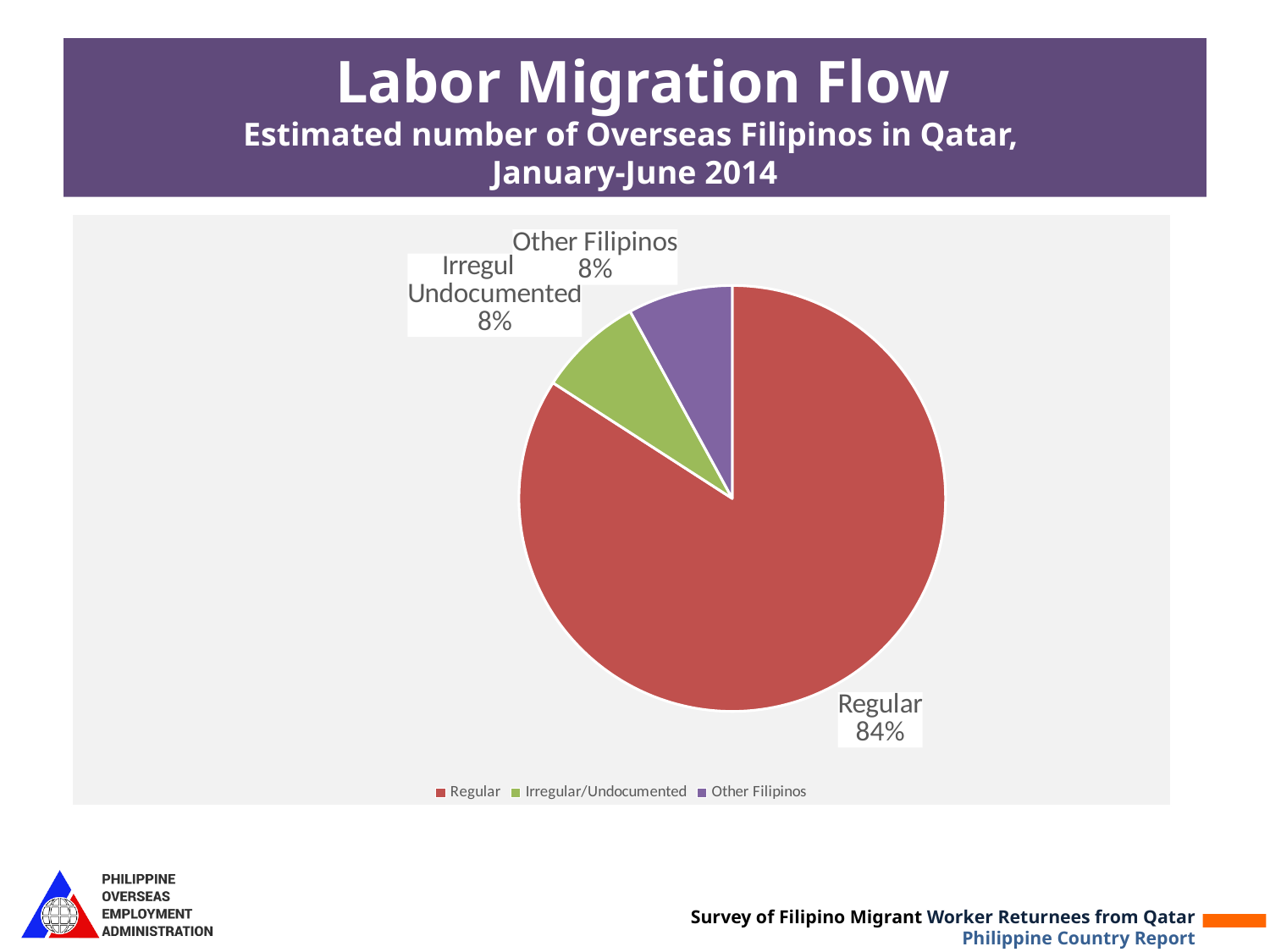
What colour is the Regular slice in the pie chart? Red Which is larger, the Regular slice or the Irregular/Undocumented slice? Regular How many entries does the legend list? 3 What is the main title of the slide? Labor Migration Flow What percentage does the Other Filipinos slice show? 8% What share of the pie does the Regular slice represent? 84% How many slices does the pie chart have? 3 What percentage of the pie chart is labelled Regular? 84% Which category has the largest slice of the pie chart? Regular What percentage does the Irregular/Undocumented slice show? 8% What is the difference in percentage points between the Regular slice and the Other Filipinos slice? 76 What kind of chart is shown on the slide? Pie chart